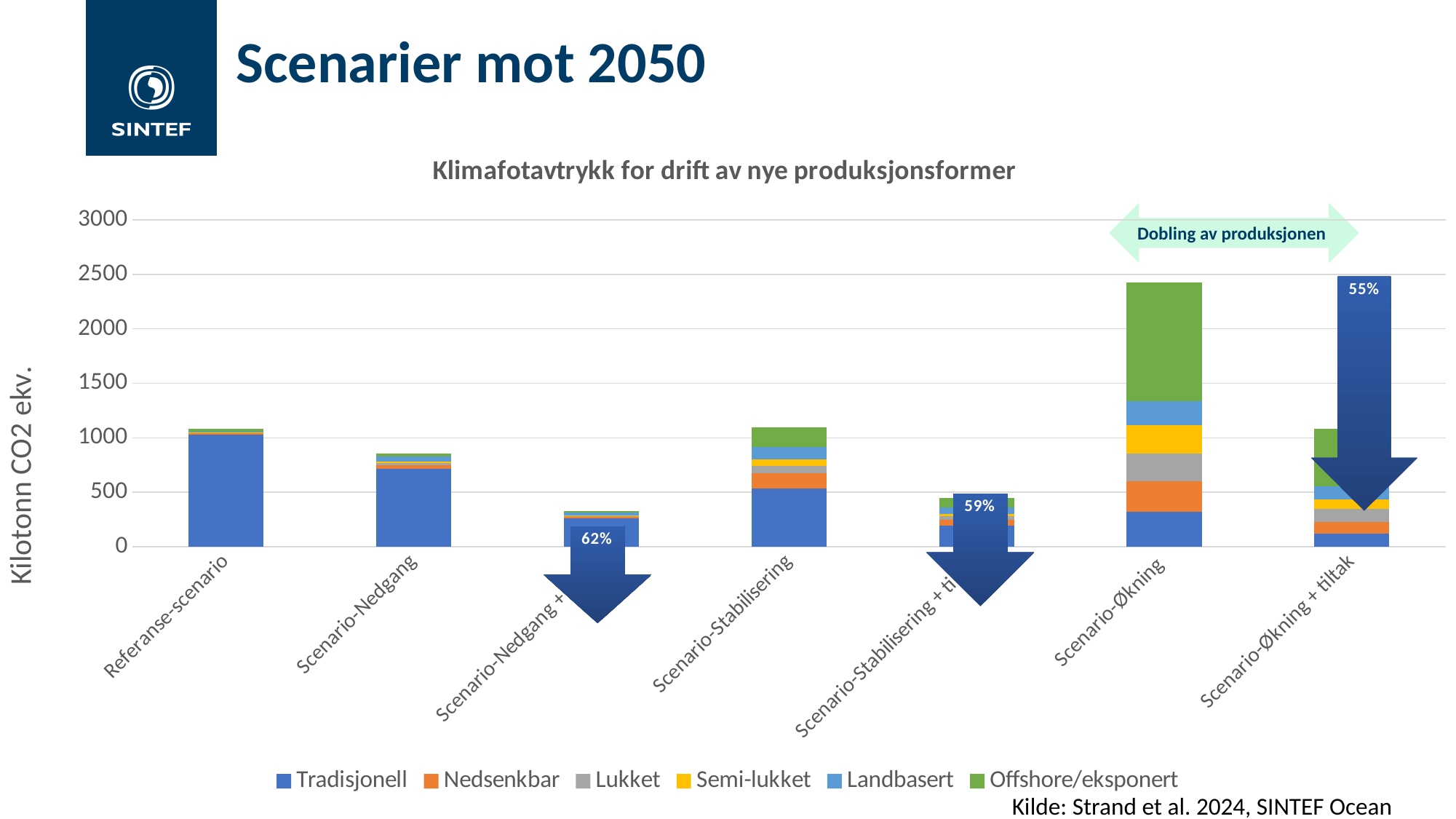
Which is larger, the total for Scenario-Økning or for Scenario-Økning + tiltak? Scenario-Økning What is the title of the chart? Klimafotavtrykk for drift av nye produksjonsformer Is the total for Referanse-scenario greater or less than 1000? greater How many series does the legend list? 6 Which series makes up the largest part of the Scenario-Økning bar? Offshore/eksponert Is the total for the third bar from the left (Scenario-Nedgang + tiltak) greater or less than 500? less How many scenario bars are plotted on the chart? 7 What percentage is printed on the arrow above the Scenario-Økning + tiltak bar? 55% Is the total for Scenario-Økning greater or less than 2000? greater What kind of chart is shown on the slide? Stacked bar chart Which scenario has the highest total climate footprint? Scenario-Økning